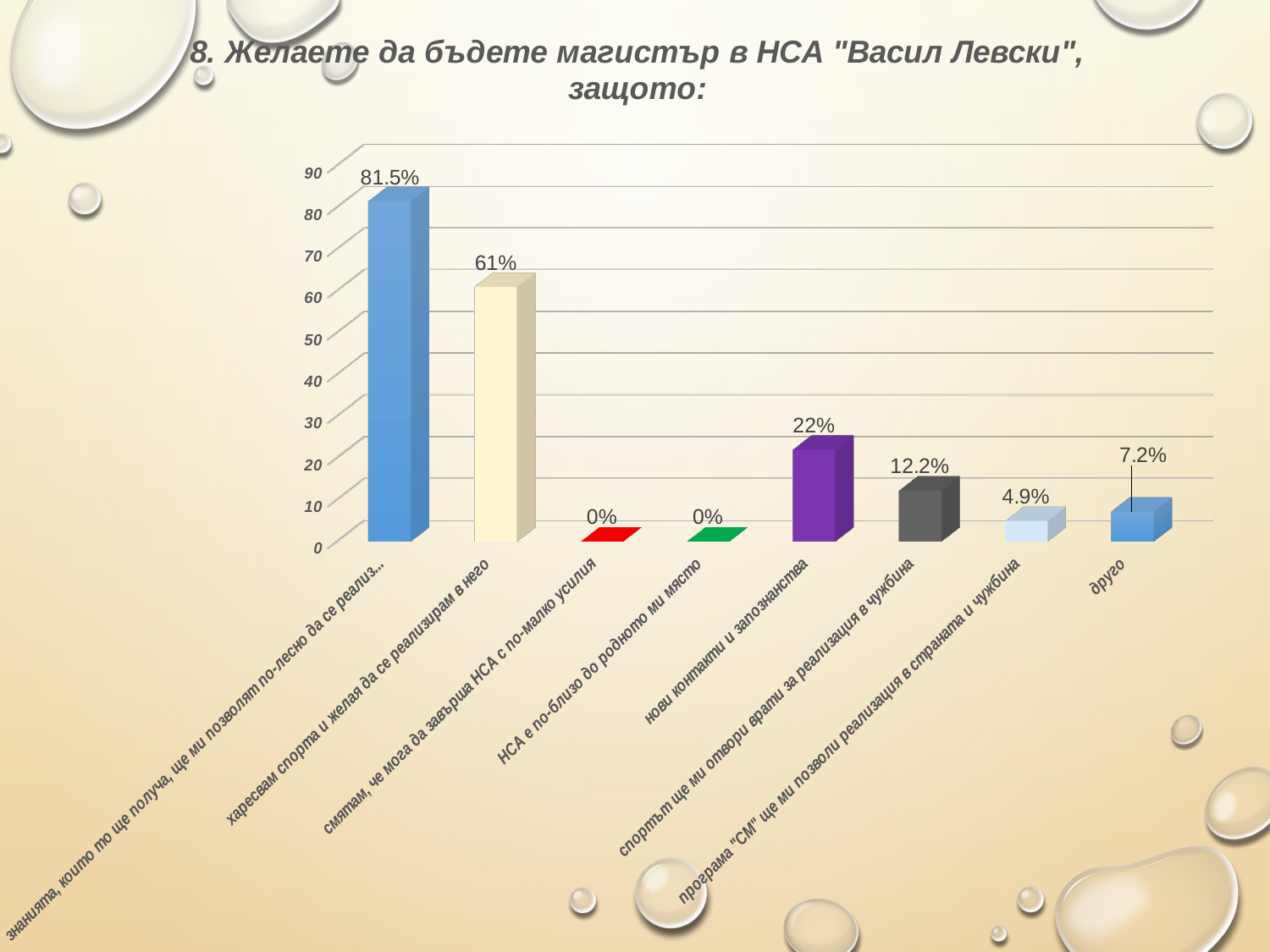
What value is shown for the category "друго"? 7.2% How many categories are shown in the chart? 8 How many categories have a value of 0%? 2 What kind of chart is shown on the slide? bar chart What value is shown for the category "нови контакти и запознанства"? 22% Is the value for "харесвам спорта и желая да се реализирам в него" greater or less than 50? greater Which category has the highest value? знанията, които ще получа, ще ми позволят по-лесно да се реализ... What value is shown for the category "спортът ще ми отвори врати за реализация в чужбина"? 12.2% What value is shown for the category "харесвам спорта и желая да се реализирам в него"? 61% What value is shown for the category "НСА е по-близо до родното ми място"? 0% Which is larger: the value for "друго" or the value for "програма "СМ" ще ми позволи реализация в страната и чужбина"? друго What is the difference between the values for "нови контакти и запознанства" and "спортът ще ми отвори врати за реализация в чужбина"? 9.8%